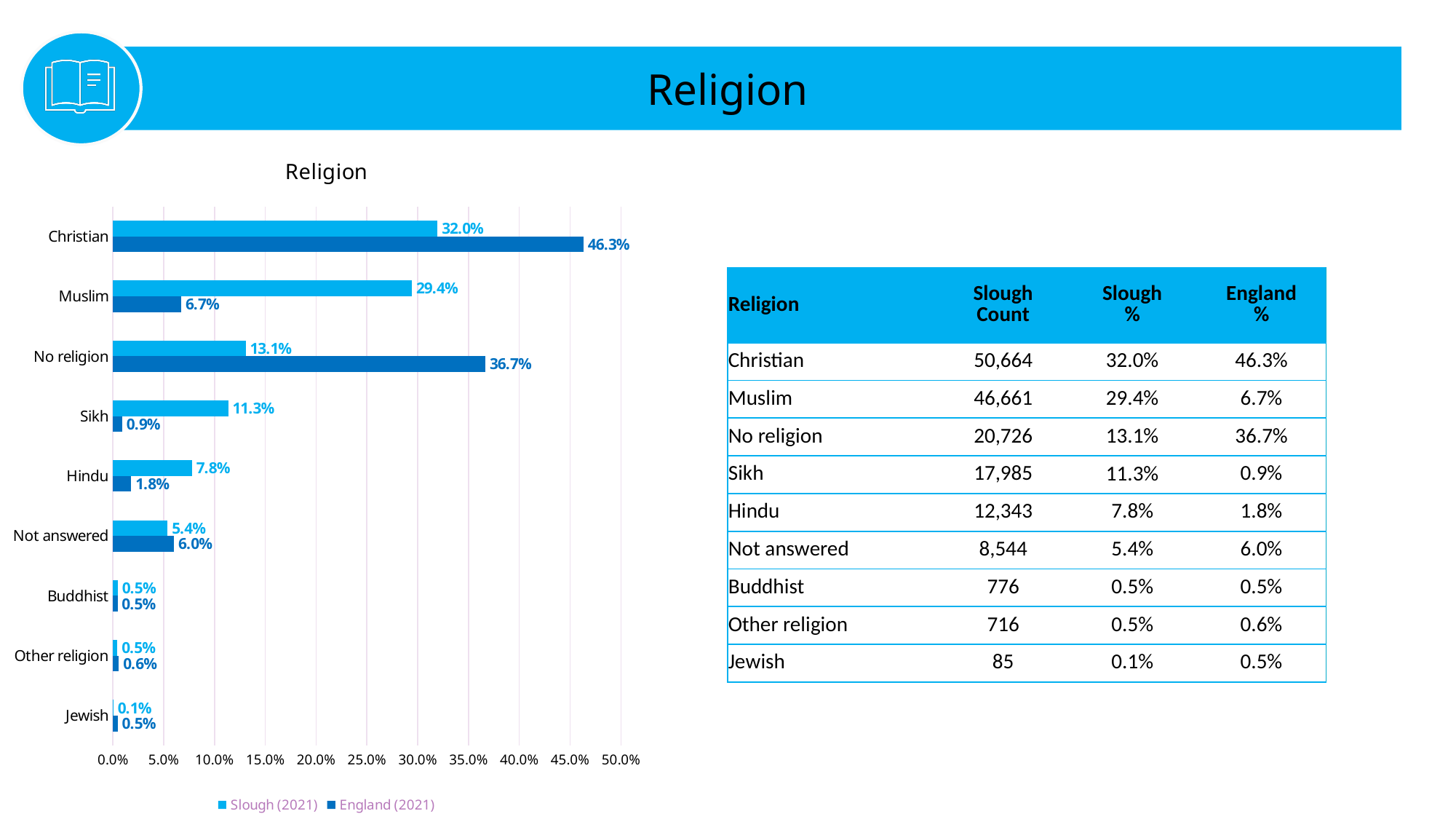
Which category has the highest England (2021) value? Christian What is the England (2021) value for No religion? 36.7% What is the difference between the England (2021) and Slough (2021) values for Christian? 14.3% Which category has the lowest Slough (2021) value? Jewish What is the title of the chart? Religion Which is larger for Hindu: the Slough (2021) value or the England (2021) value? Slough (2021) How many categories are shown on the chart? 9 What is the Slough (2021) value for Muslim? 29.4% What is the England (2021) value for Sikh? 0.9% What kind of chart is shown on the slide? Bar chart How many series does the legend list? 2 Is the Slough (2021) value for No religion greater or less than 10.0%? greater